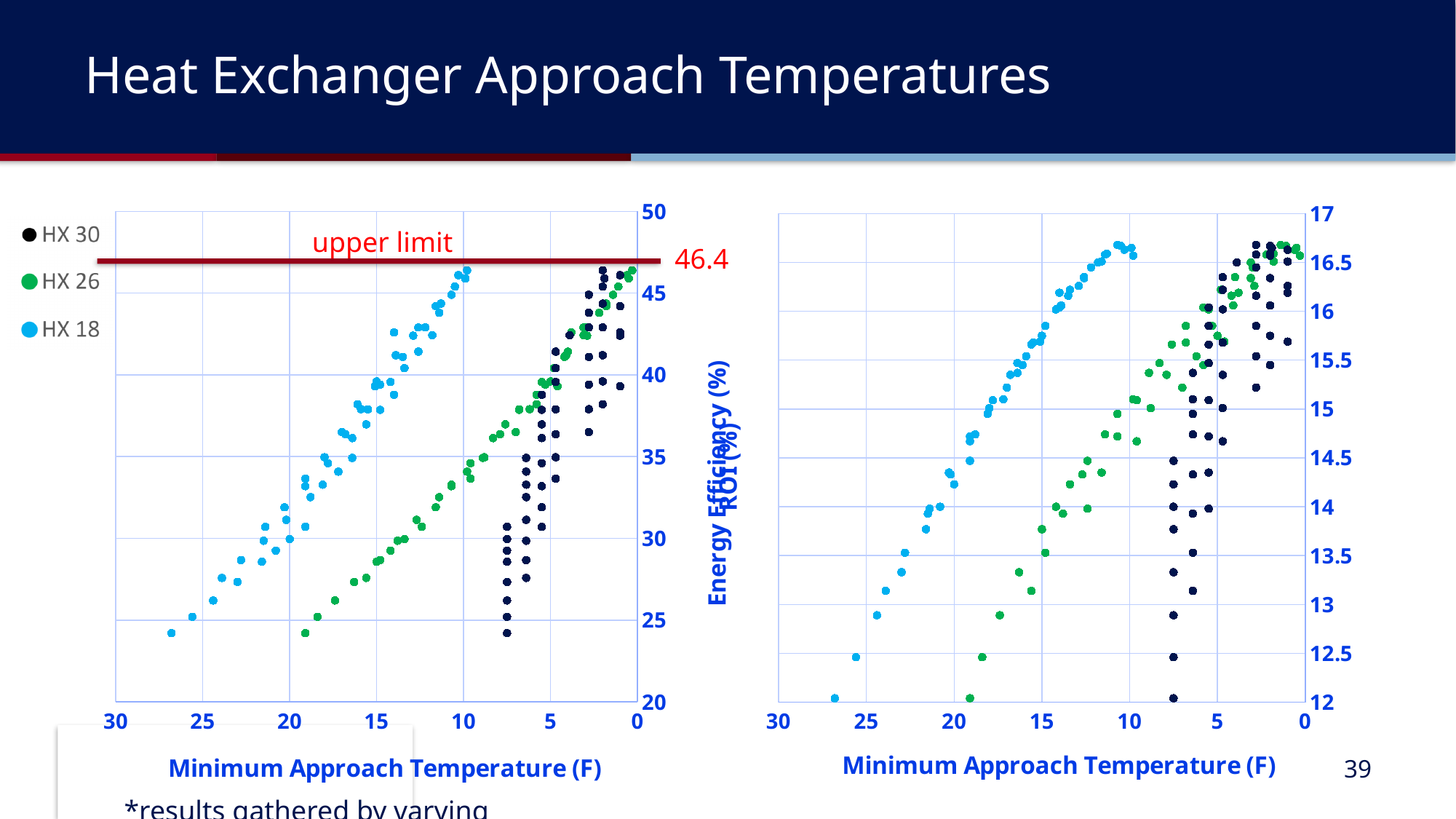
On the left chart (Energy Efficiency), is the HX 26 value at a minimum approach temperature of 15 F greater or less than 30? less On the left chart (Energy Efficiency), at a minimum approach temperature of 15 F, which series has the higher value, HX 18 or HX 26? HX 18 On the left chart (Energy Efficiency), is the HX 18 value at a minimum approach temperature of 15 F greater or less than 35? greater On the right chart (ROI), at a minimum approach temperature of 15 F, which series has the higher value, HX 18 or HX 26? HX 18 On the right chart (ROI), do the values rise or fall as you move from left to right along the x axis? rise What are the three series named in the legend? HX 30, HX 26, HX 18 What kind of chart is the left chart on the slide? scatter chart How many series does the legend list? 3 On the left chart (Energy Efficiency), what value is the 'upper limit' line labelled with? 46.4 What is the label of the x axis on both charts? Minimum Approach Temperature (F) On the left chart (Energy Efficiency), do the values rise or fall as you move from left to right along the x axis? rise